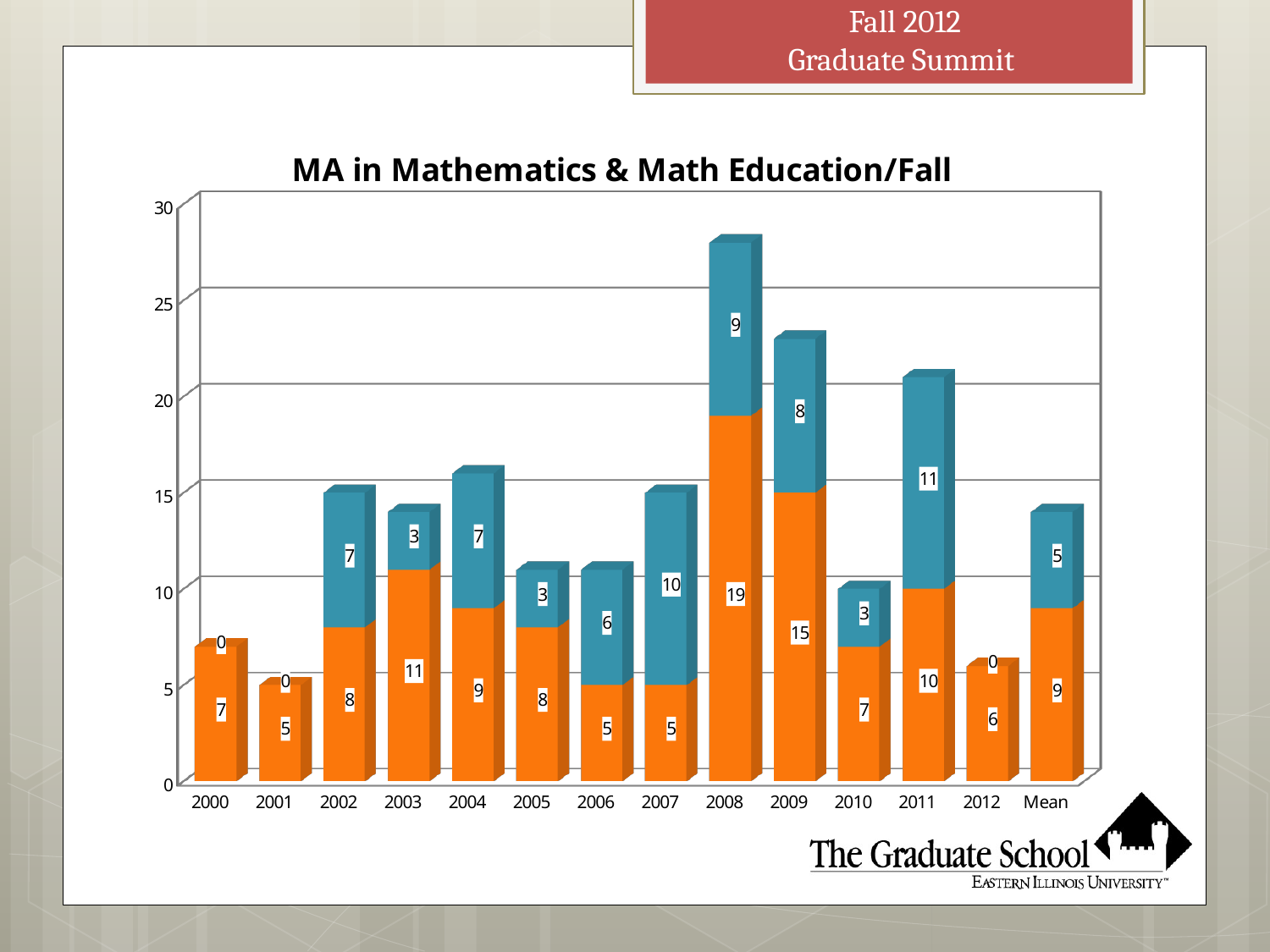
What is the value of the orange segment for 2008? 19 What is the total of the stacked bar for 2009? 23 What is the total of the stacked bar for 2008? 28 What type of chart is shown? Stacked bar chart Which year has the shortest stacked bar? 2001 What is the value of the orange segment for the Mean bar? 9 How many categories are shown on the x axis? 14 What is the title of the chart? MA in Mathematics & Math Education/Fall What is the value of the teal segment for 2011? 11 Is the orange segment for 2003 larger than the orange segment for 2004? Yes, 2003 (11) is larger than 2004 (9) Which year has the tallest stacked bar? 2008 What is the difference between the orange segment values for 2008 and 2009? 4